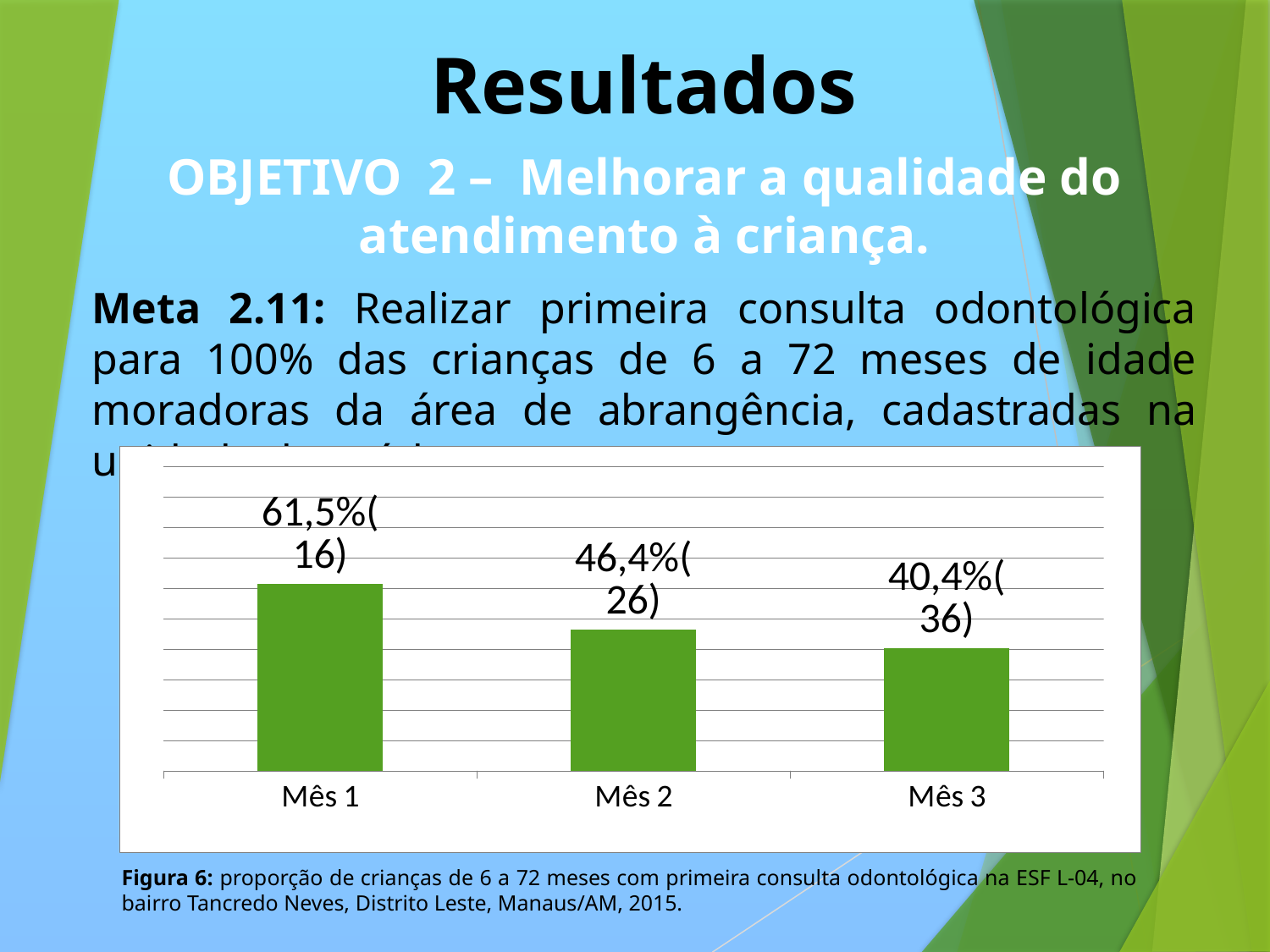
What is the difference in percentage points between Mês 1 and Mês 2? 15,1 Which is larger, the percentage for Mês 2 or for Mês 3? Mês 2 What is the percentage shown for Mês 2? 46,4% What type of chart is shown on the slide? Bar chart Do the percentages rise or fall from Mês 1 to Mês 3? Fall How many months (categories) are shown in the chart? 3 What is the percentage shown for Mês 3? 40,4% What is the difference in percentage points between Mês 1 and Mês 3? 21,1 Which month has the lowest percentage? Mês 3 Which month has the highest percentage? Mês 1 What is the percentage shown for Mês 1? 61,5% What number appears in parentheses in the data label for Mês 3? 36